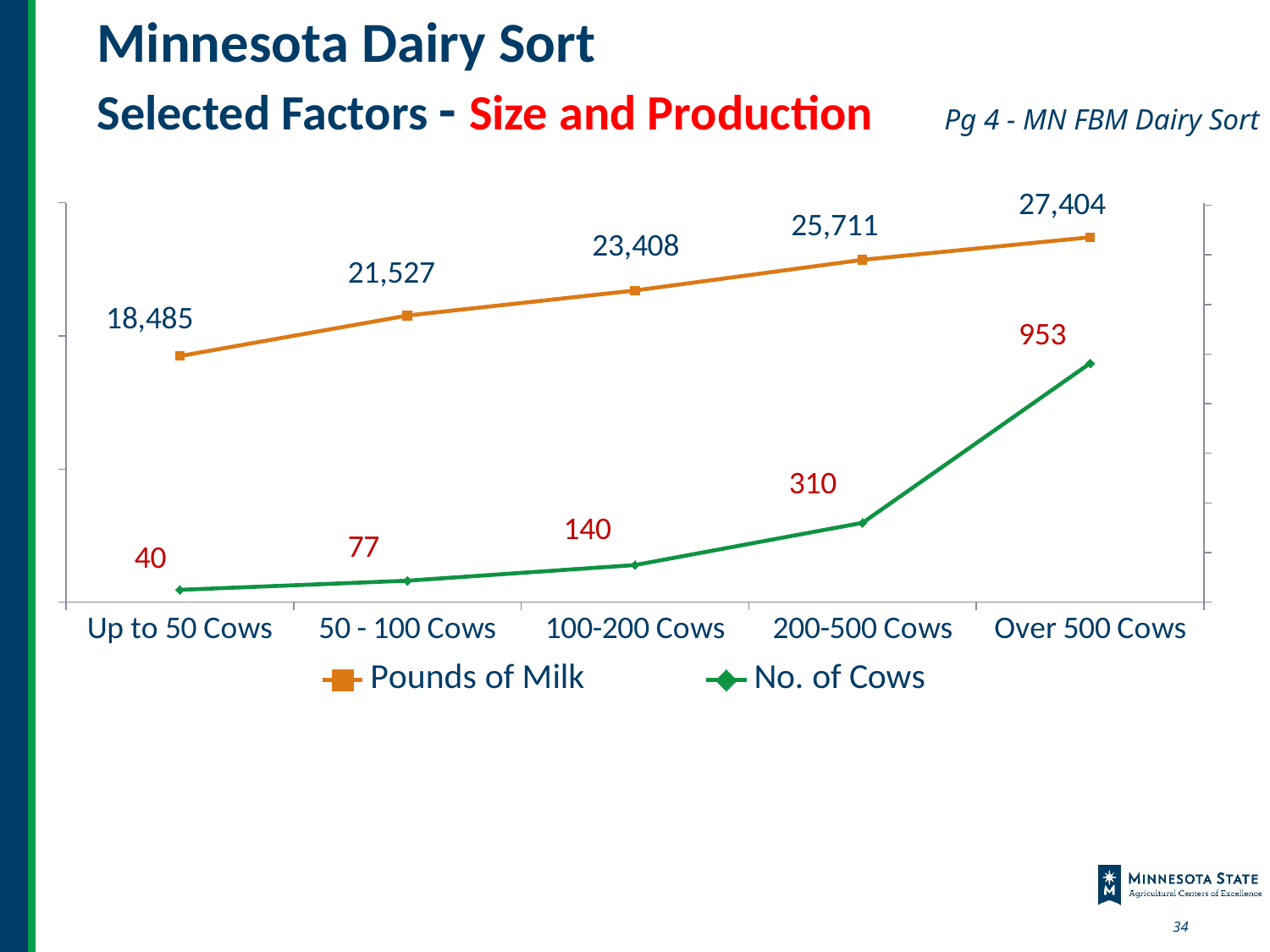
What is the No. of Cows value for the 200-500 Cows category? 310 Do the Pounds of Milk values rise or fall from Up to 50 Cows to Over 500 Cows? Rise What is the Pounds of Milk value for the Up to 50 Cows category? 18,485 What is the Pounds of Milk value for the 100-200 Cows category? 23,408 Which category has the lowest Pounds of Milk value? Up to 50 Cows How many series does the legend list? 2 What is the difference in No. of Cows between the 200-500 Cows and 100-200 Cows categories? 170 How many categories are shown on the x axis? 5 Which is larger: the Pounds of Milk value for 50 - 100 Cows or for 200-500 Cows? 200-500 Cows What kind of chart is shown on the slide? Line chart What is the difference in Pounds of Milk between the Over 500 Cows and Up to 50 Cows categories? 8,919 Which category has the highest No. of Cows value? Over 500 Cows